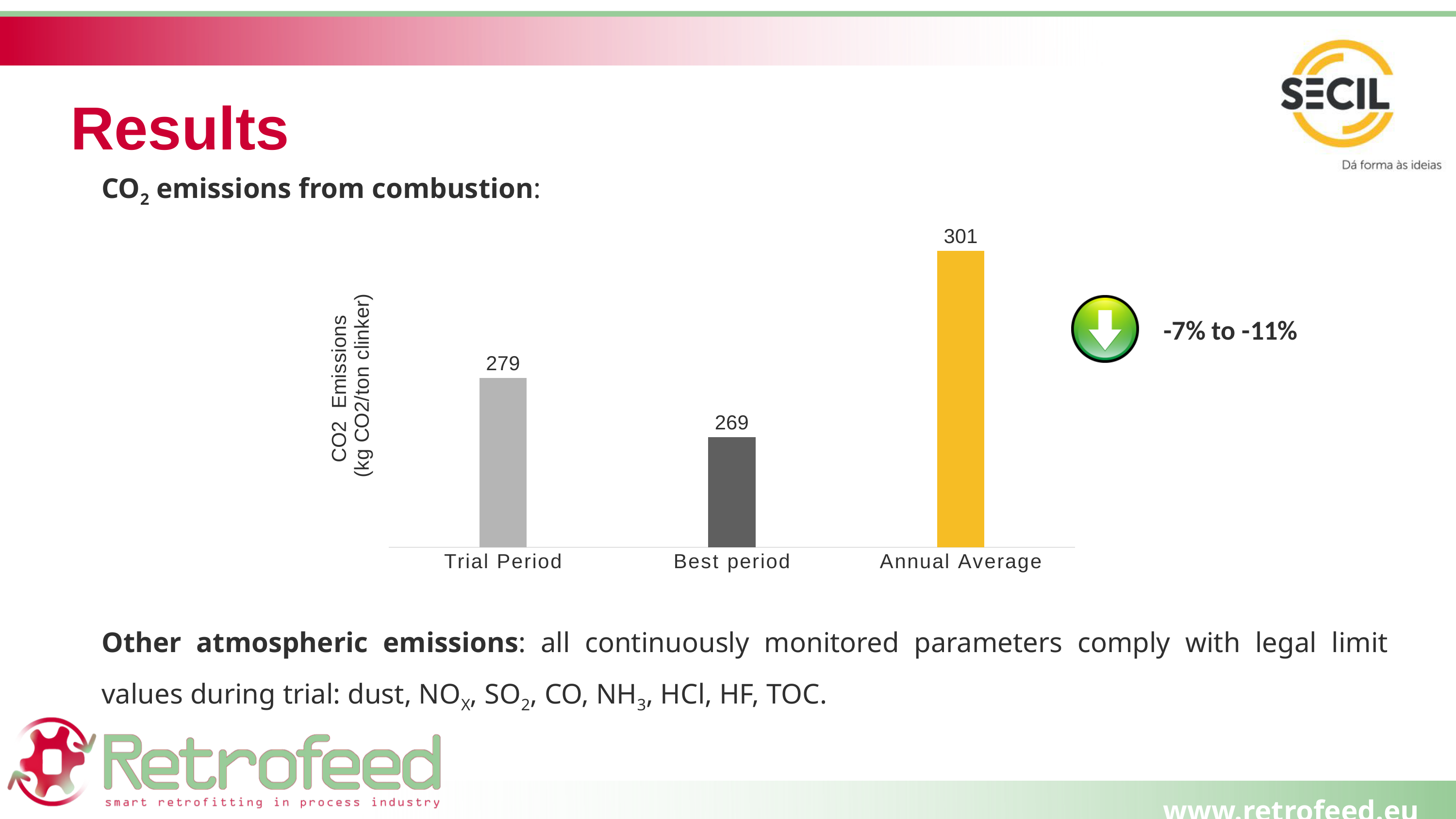
Which is larger, the value for the Trial Period or the Best period? Trial Period What colour is the bar for the Annual Average? Yellow What kind of chart is shown on the slide? Bar chart What is the CO2 emissions value for the Annual Average? 301 Which category has the highest CO2 emissions value? Annual Average What is the CO2 emissions value for the Trial Period? 279 What is the label of the vertical axis of the chart? CO2 Emissions (kg CO2/ton clinker) How many categories are shown on the x axis of the chart? 3 What is the difference between the Trial Period and the Best period values? 10 Which category has the lowest CO2 emissions value? Best period What is the CO2 emissions value for the Best period? 269 What is the difference between the Annual Average and the Trial Period values? 22